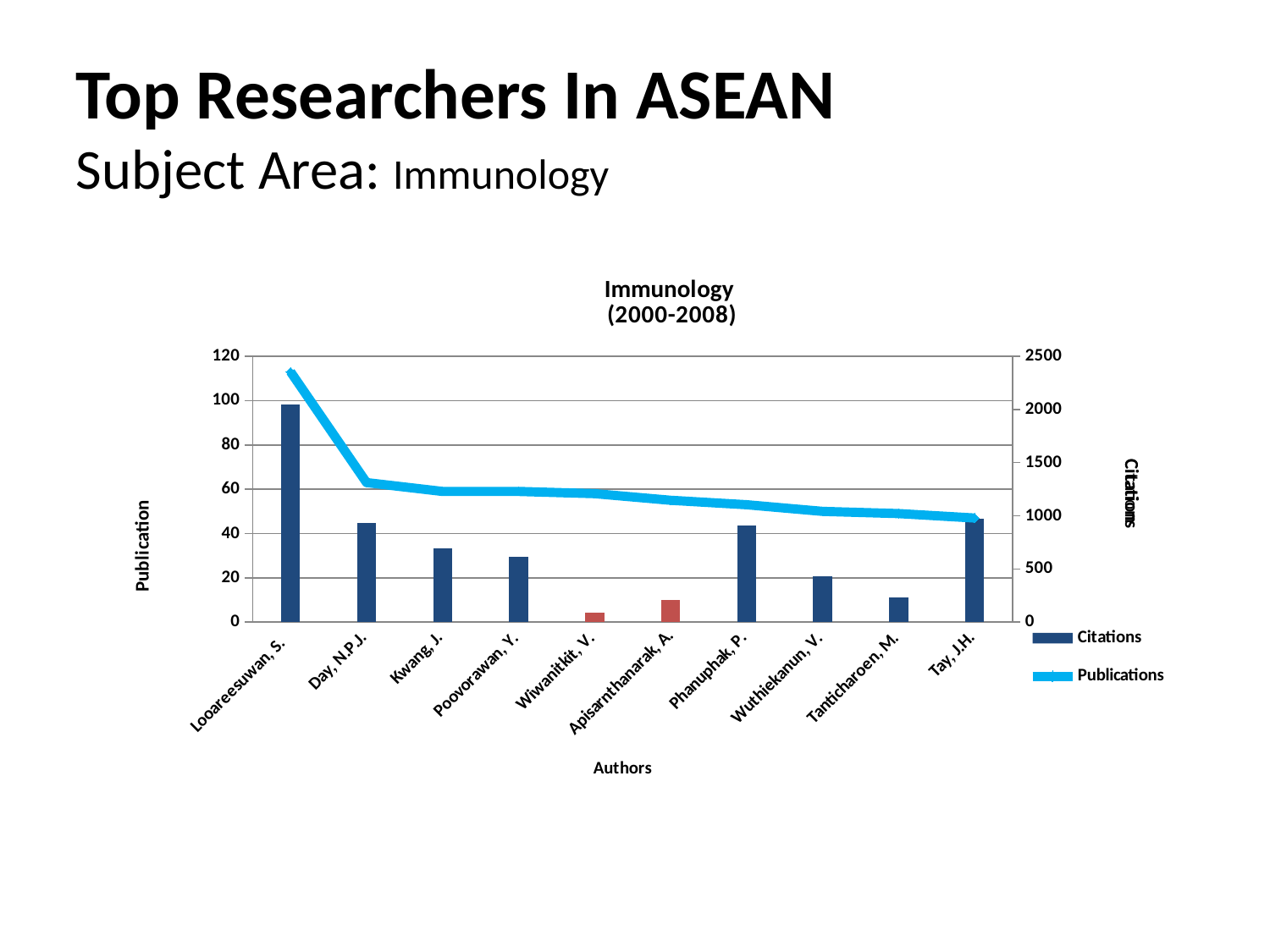
What kind of chart is shown on the slide? A combination bar and line chart Is the bar value for Wuthiekanun, V. greater or less than 40 on the left axis? less Is the bar value for Kwang, J. greater or less than 40 on the left axis? less Which author has the tallest bar? Looareesuwan, S. Which author has the shortest bar? Wiwanitkit, V. How many authors are shown on the x axis? 10 Is the bar value for Looareesuwan, S. greater or less than 80 on the left axis? greater What are the two entries listed in the chart legend? Citations and Publications Which has the taller bar, Phanuphak, P. or Wuthiekanun, V.? Phanuphak, P. Does the line series rise or fall from left to right across the authors? It falls How many series does the legend list? 2